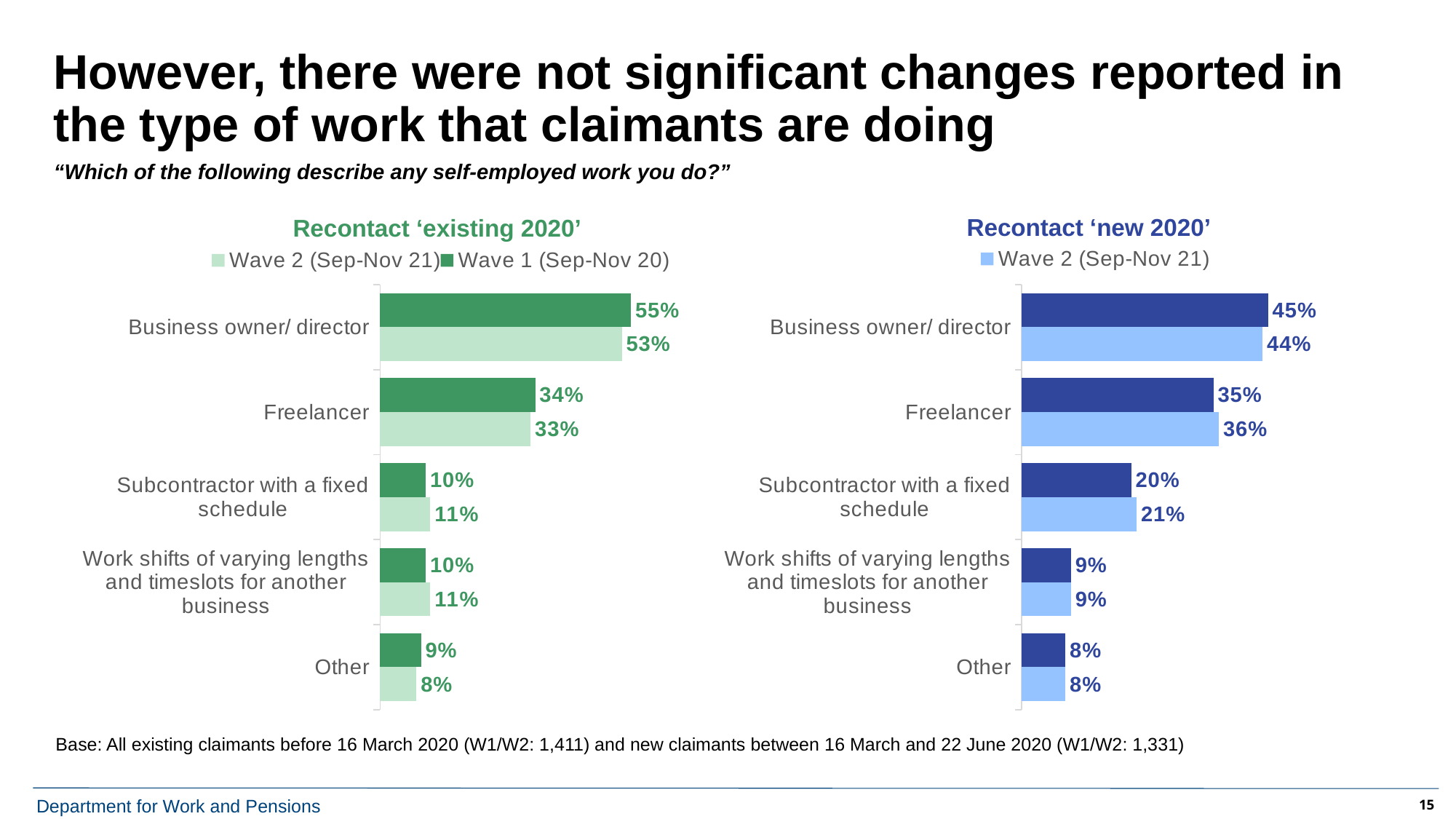
In the 'Recontact ‘existing 2020’' chart, what is the Wave 2 (Sep-Nov 21) value for Freelancer? 33% In the 'Recontact ‘existing 2020’' chart, what is the difference between the Wave 1 (Sep-Nov 20) and Wave 2 (Sep-Nov 21) values for Business owner/ director? 2% In the 'Recontact ‘new 2020’' chart, which category has the lowest Wave 2 (Sep-Nov 21) value? Other In the 'Recontact ‘existing 2020’' chart, which category has the highest Wave 2 (Sep-Nov 21) value? Business owner/ director In the 'Recontact ‘existing 2020’' chart, what is the Wave 1 (Sep-Nov 20) value for Business owner/ director? 55% In the 'Recontact ‘new 2020’' chart, what is the Wave 2 (Sep-Nov 21) value for Subcontractor with a fixed schedule? 21% In the 'Recontact ‘new 2020’' chart, what is the Wave 2 (Sep-Nov 21) value for Business owner/ director? 44% How many series does the legend of the 'Recontact ‘existing 2020’' chart list? 2 In the 'Recontact ‘existing 2020’' chart, which is larger for Freelancer: the Wave 1 (Sep-Nov 20) value or the Wave 2 (Sep-Nov 21) value? Wave 1 (Sep-Nov 20) How many categories are shown in the 'Recontact ‘new 2020’' chart? 5 In the 'Recontact ‘new 2020’' chart, what is the difference between the Wave 2 (Sep-Nov 21) values for Business owner/ director and Freelancer? 8% What type of chart is the 'Recontact ‘existing 2020’' chart? Bar chart